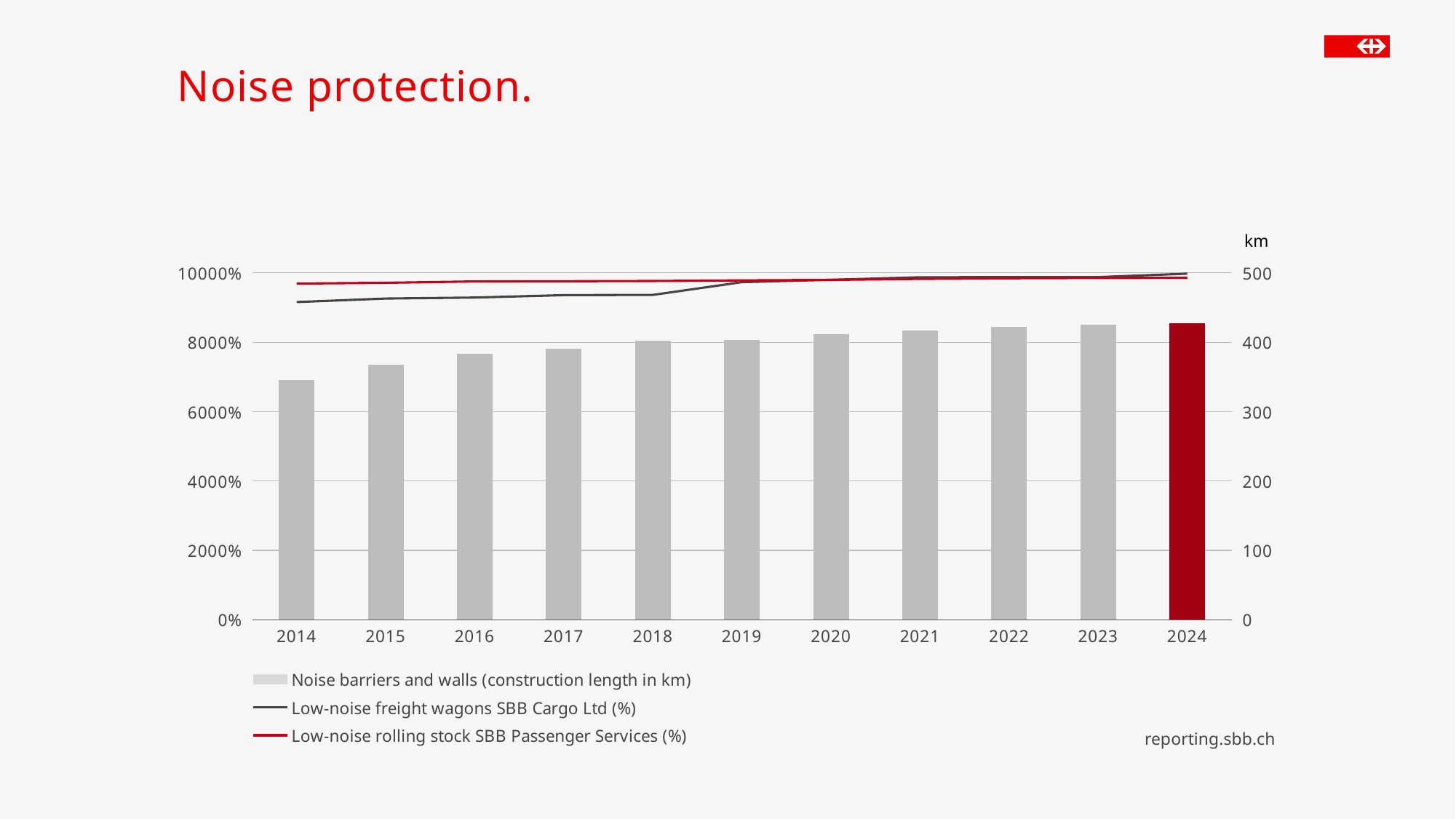
Which year's bar is highlighted in red? 2024 Which year has the highest bar for noise barriers and walls? 2024 Is the value for noise barriers and walls in 2014 greater or less than 400 km? less What kind of chart is shown on the slide? A combined bar and line chart How many years are shown on the x axis? 11 How many series does the legend list? 3 What unit is shown at the top of the right-hand axis? km Is the value for noise barriers and walls in 2016 greater or less than 400 km? less Is the value for noise barriers and walls in 2024 greater or less than 400 km? greater Do the bars for noise barriers and walls rise or fall from 2014 to 2024? Rise In 2014, which line is higher: low-noise freight wagons SBB Cargo Ltd or low-noise rolling stock SBB Passenger Services? Low-noise rolling stock SBB Passenger Services Which year has the lowest bar for noise barriers and walls? 2014